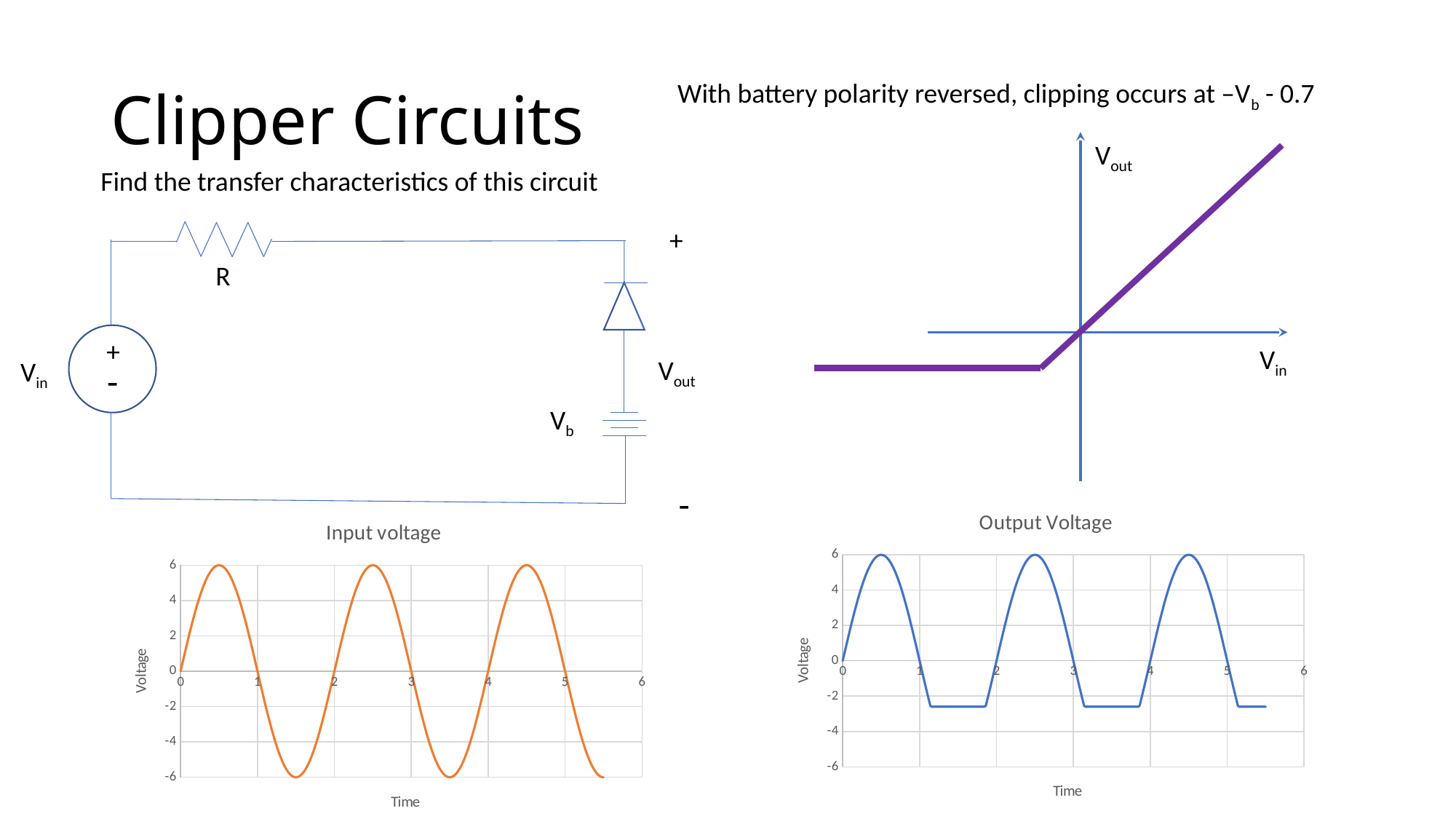
In the "Input voltage" chart, what is the maximum value reached by the waveform? 6 What type of chart is the "Input voltage" chart? line chart What is the label of the horizontal axis in the "Output Voltage" chart? Time In the "Output Voltage" chart, is the minimum (clipped) value greater or less than -4? greater In the "Output Voltage" chart, is the minimum (clipped) value greater or less than -2? less In the "Input voltage" chart, what is the highest value shown on the horizontal axis? 6 Which chart has the lower minimum value, "Input voltage" or "Output Voltage"? Input voltage In the "Output Voltage" chart, what is the maximum value reached by the waveform? 6 In the "Input voltage" chart, what is the minimum value reached by the waveform? -6 What is the label of the vertical axis in the "Input voltage" chart? Voltage What type of chart is the "Output Voltage" chart? line chart How many positive peaks does the waveform in the "Input voltage" chart show? 3